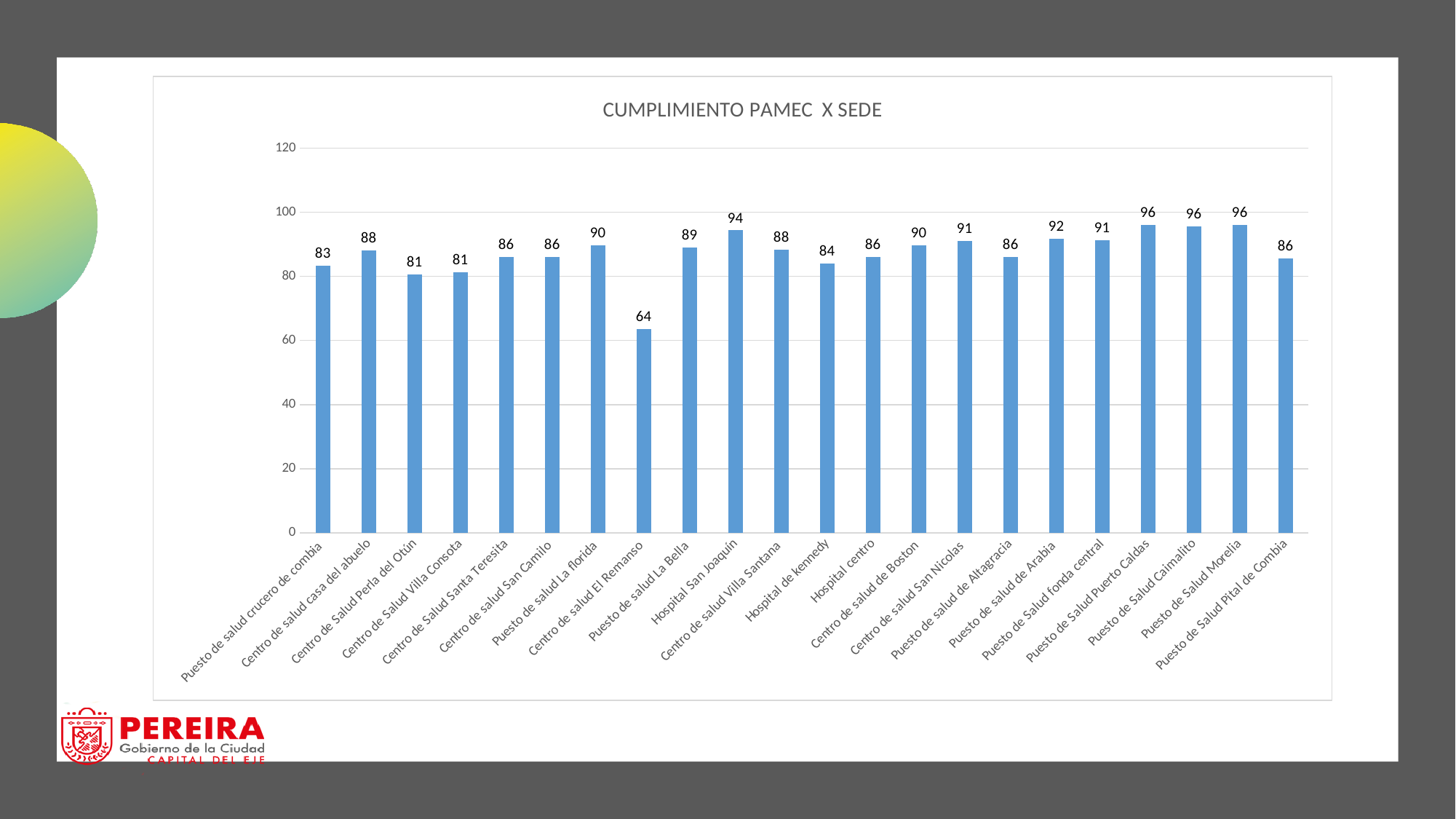
Which sede has the lowest value? Centro de salud El Remanso What is the value for Puesto de salud de Arabia? 92 What is the value for Hospital San Joaquín? 94 How many sedes are shown on the chart? 22 What kind of chart is this? Bar chart What is the highest value shown on the chart? 96 Is the value for Centro de salud El Remanso greater or less than 80? less What is the title of the chart? CUMPLIMIENTO PAMEC X SEDE What is the value for Centro de Salud Perla del Otún? 81 What is the difference between the values for Hospital San Joaquín and Centro de salud El Remanso? 30 Which is larger, the value for Puesto de salud La florida or the value for Hospital de kennedy? Puesto de salud La florida What is the value for Centro de salud El Remanso? 64